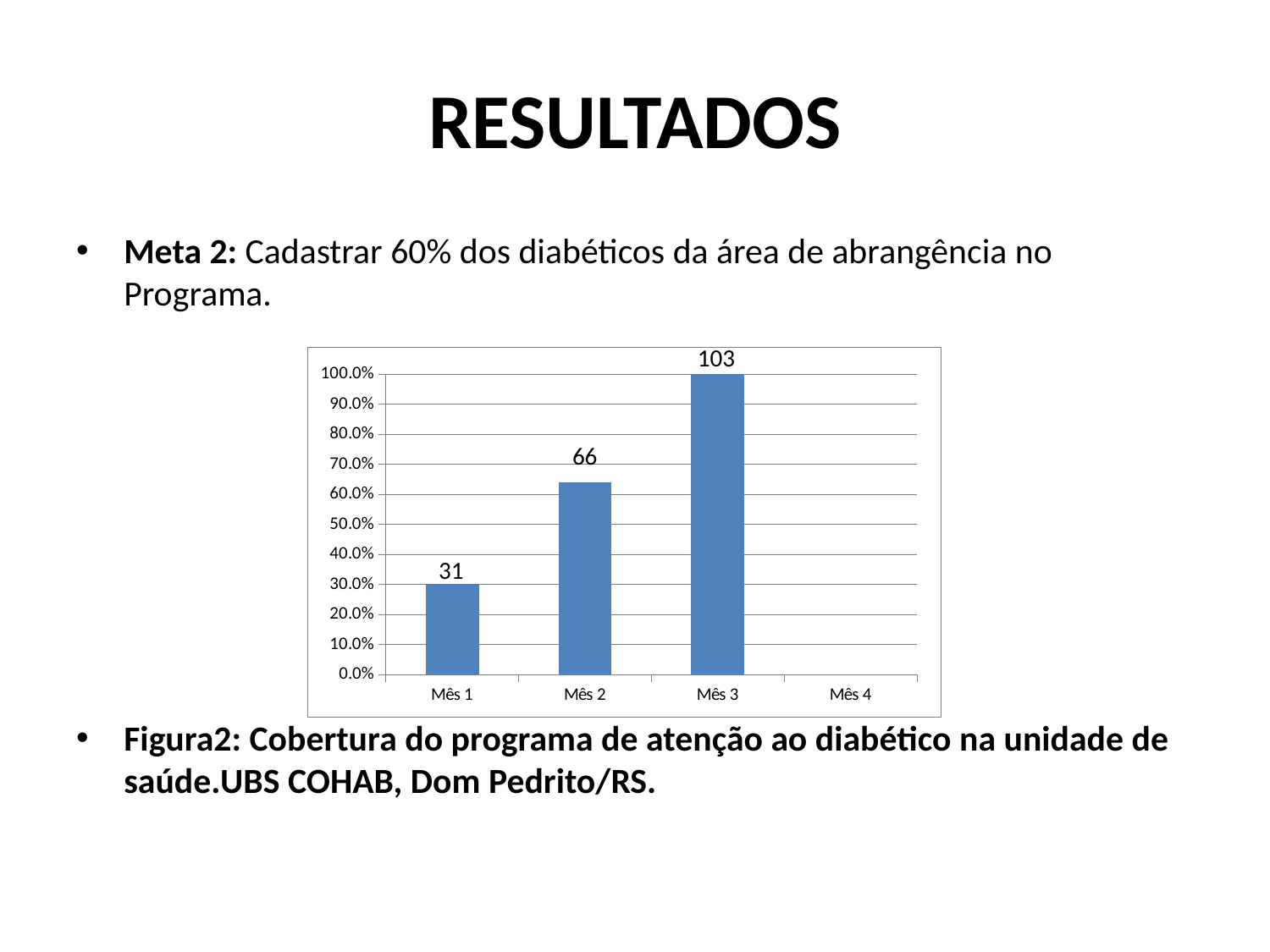
Is the bar for Mês 1 greater or less than 40.0% on the y axis? less Among the months that have a bar, which has the shortest bar? Mês 1 What data label is shown above the bar for Mês 3? 103 Which month has the tallest bar in the chart? Mês 3 How many month categories are shown on the x axis? 4 Is the bar for Mês 2 greater or less than 50.0% on the y axis? greater What kind of chart is shown on the slide? Bar chart What is the difference between the data labels for Mês 3 and Mês 1? 72 Which is larger, the bar for Mês 2 or the bar for Mês 1? Mês 2 What is the difference between the data labels for Mês 2 and Mês 1? 35 What data label is shown above the bar for Mês 1? 31 What data label is shown above the bar for Mês 2? 66